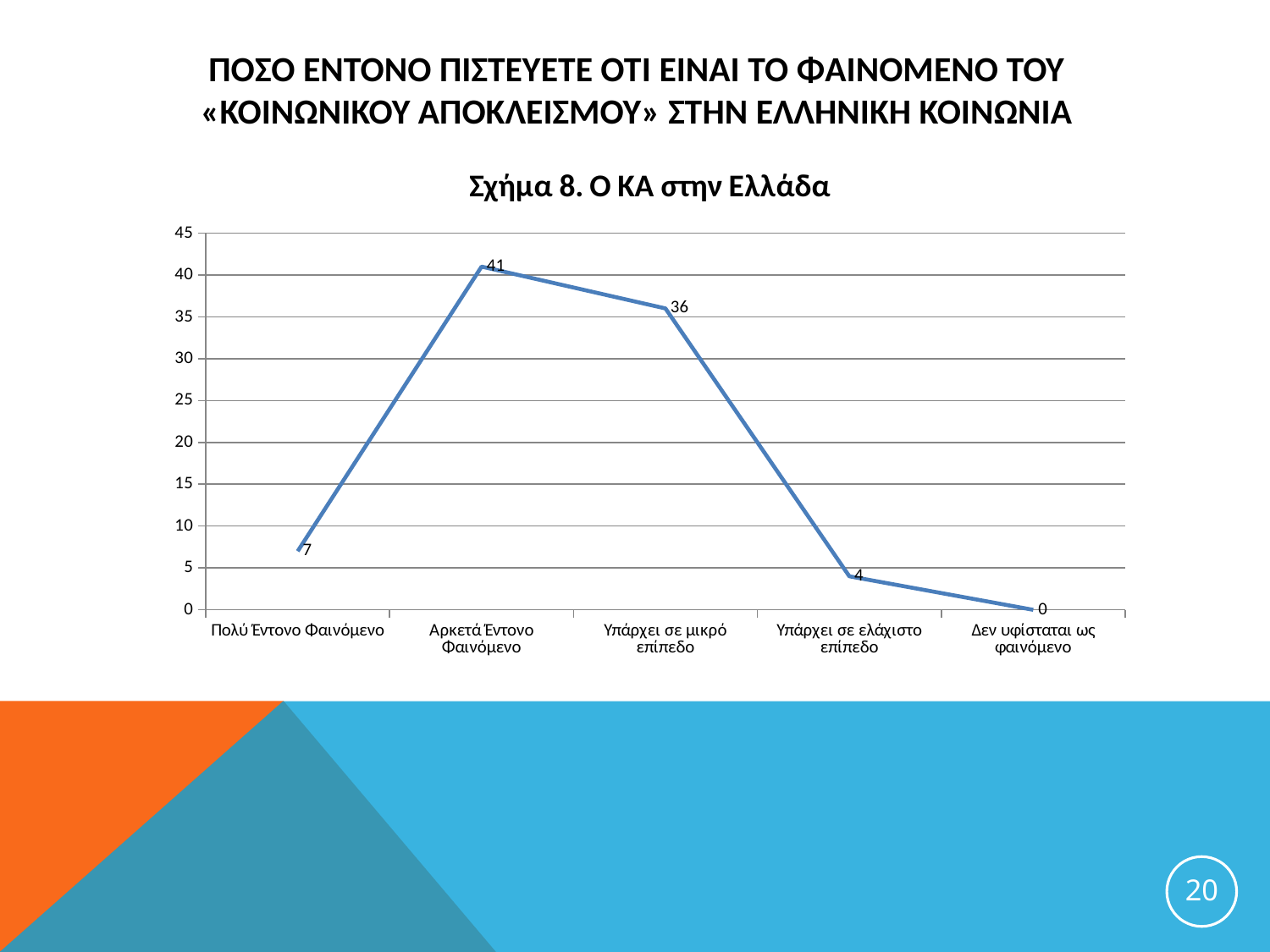
What is the difference between the values for «Αρκετά Έντονο Φαινόμενο» and «Υπάρχει σε μικρό επίπεδο»? 5 What is the value for «Πολύ Έντονο Φαινόμενο»? 7 Which category has the lowest value? Δεν υφίσταται ως φαινόμενο Do the values rise or fall from «Αρκετά Έντονο Φαινόμενο» to «Δεν υφίσταται ως φαινόμενο»? Fall What kind of chart is shown on the slide? Line chart What is the value for «Αρκετά Έντονο Φαινόμενο»? 41 What is the value for «Δεν υφίσταται ως φαινόμενο»? 0 What is the value for «Υπάρχει σε μικρό επίπεδο»? 36 How many categories are shown on the x axis? 5 Which is larger, the value for «Πολύ Έντονο Φαινόμενο» or the value for «Υπάρχει σε ελάχιστο επίπεδο»? Πολύ Έντονο Φαινόμενο What is the title of the chart? Σχήμα 8. Ο ΚΑ στην Ελλάδα Which category has the highest value? Αρκετά Έντονο Φαινόμενο